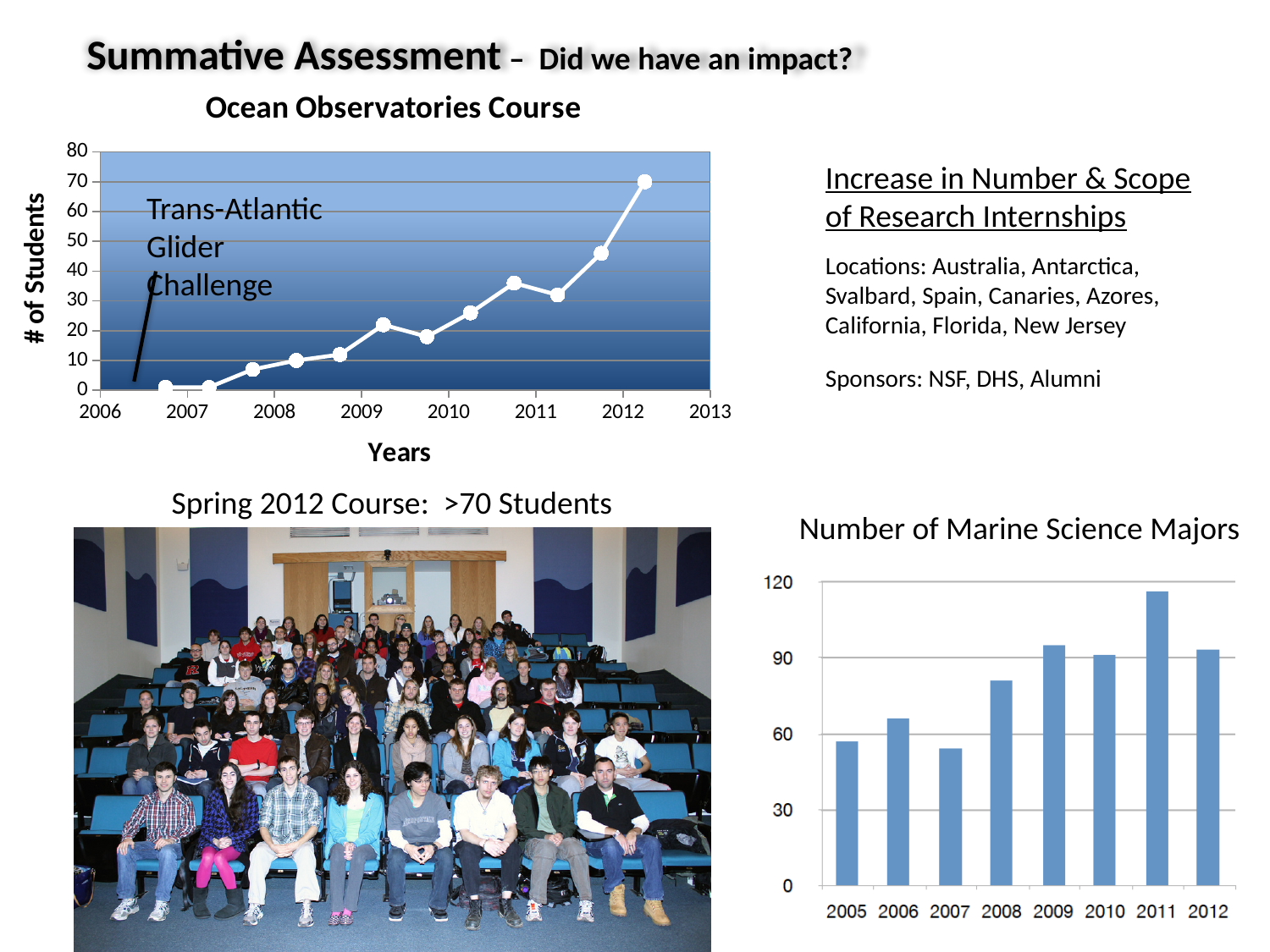
In the Ocean Observatories Course chart, what type of chart is used? line chart In the Number of Marine Science Majors chart, which year has the highest number of majors? 2011 In the Number of Marine Science Majors chart, how many years (bars) are shown? 8 In the Ocean Observatories Course chart, is the last plotted value (in 2012) greater or less than 60? greater In the Ocean Observatories Course chart, do the values generally rise or fall from 2006 to 2012? rise In the Number of Marine Science Majors chart, is the value for 2007 greater or less than 60? less In the Number of Marine Science Majors chart, which is larger, the value for 2008 or the value for 2006? 2008 In the Ocean Observatories Course chart, what is the label of the y axis? # of Students In the Ocean Observatories Course chart, what is the label of the x axis? Years In the Number of Marine Science Majors chart, is the value for 2011 greater or less than 90? greater In the Number of Marine Science Majors chart, what type of chart is used? bar chart In the Ocean Observatories Course chart, how many data points are plotted on the line? 12